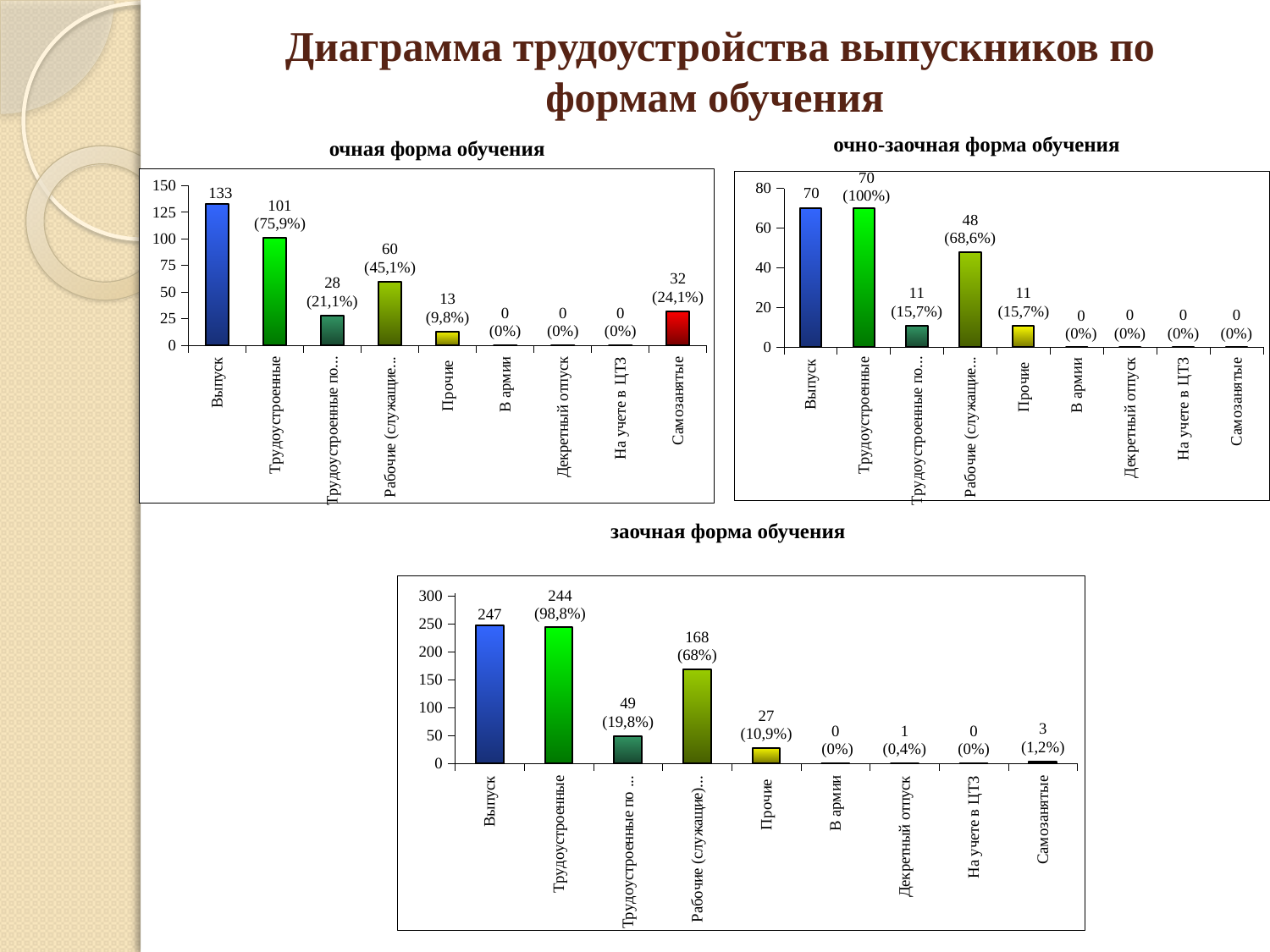
How many categories are shown in the chart titled "очная форма обучения"? 9 In the chart titled "очная форма обучения", what is the value for Самозанятые? 32 (24,1%) In the chart titled "заочная форма обучения", what is the value for Трудоустроенные? 244 (98,8%) What kind of chart is the chart titled "заочная форма обучения"? bar chart How many charts are shown on the slide? 3 In the chart titled "очно-заочная форма обучения", what is the value for Рабочие (служащие...)? 48 (68,6%) In the chart titled "заочная форма обучения", which is larger: Прочие or Трудоустроенные по ...? Трудоустроенные по ... In the chart titled "заочная форма обучения", which category has the highest value? Выпуск In the chart titled "очно-заочная форма обучения", is the value for Трудоустроенные greater or less than 60? greater In the chart titled "очная форма обучения", what is the difference between Выпуск and Трудоустроенные? 32 In the chart titled "заочная форма обучения", what is the value for Декретный отпуск? 1 (0,4%) In the chart titled "очная форма обучения", what is the value for Выпуск? 133